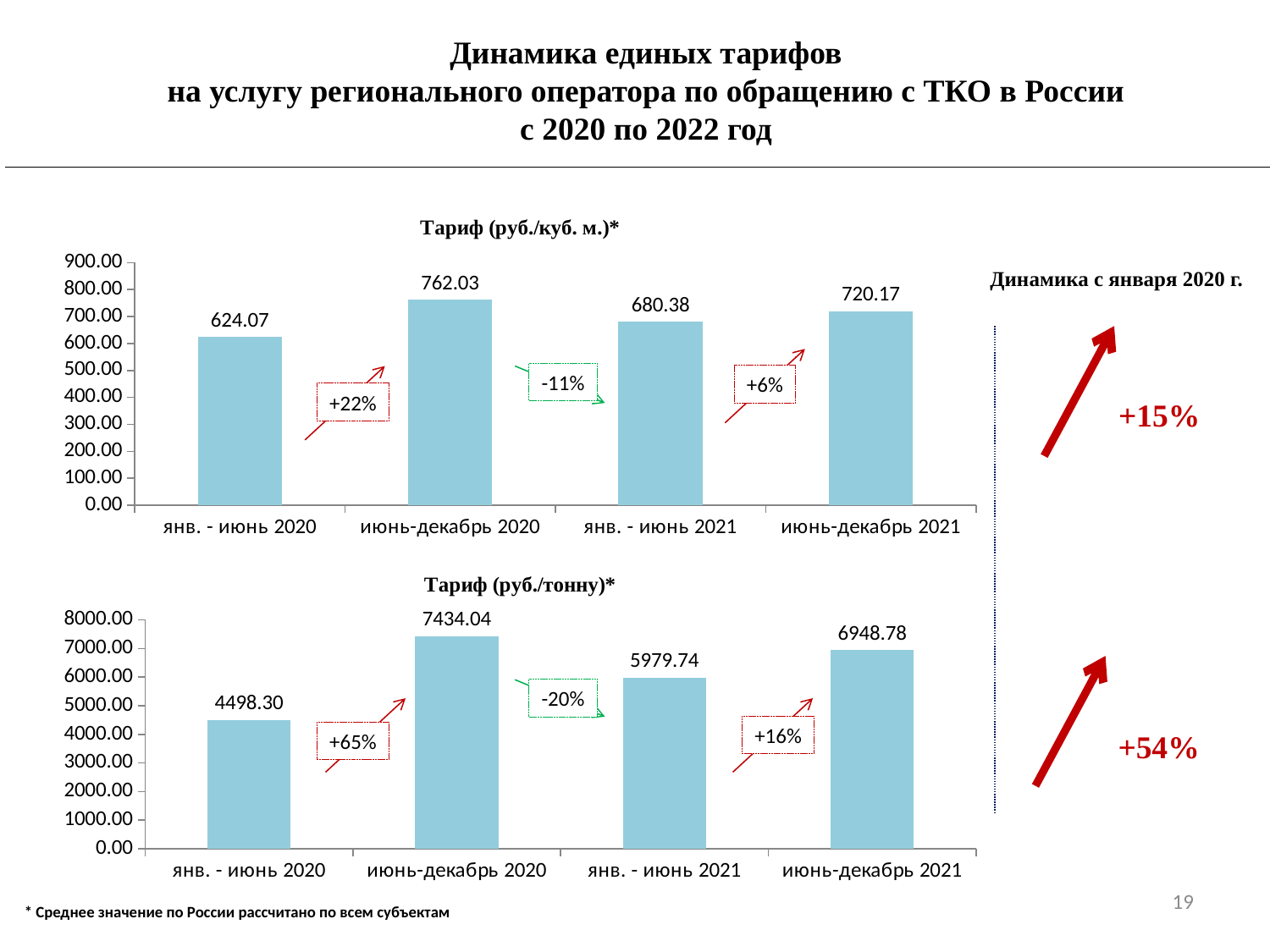
In the chart titled "Тариф (руб./куб. м.)*", which is larger: the value for "янв. - июнь 2021" or the value for "июнь-декабрь 2021"? июнь-декабрь 2021 In the chart titled "Тариф (руб./тонну)*", what is the value for "янв. - июнь 2021"? 5979.74 What is the title of the bottom chart on the slide? Тариф (руб./тонну)* In the chart titled "Тариф (руб./тонну)*", what is the difference between the values for "июнь-декабрь 2020" and "янв. - июнь 2020"? 2935.74 How many categories are shown in the chart titled "Тариф (руб./куб. м.)*"? 4 In the chart titled "Тариф (руб./куб. м.)*", what is the difference between the values for "июнь-декабрь 2020" and "янв. - июнь 2020"? 137.96 In the chart titled "Тариф (руб./тонну)*", which category has the highest value? июнь-декабрь 2020 In the chart titled "Тариф (руб./куб. м.)*", what is the value for "июнь-декабрь 2020"? 762.03 In the chart titled "Тариф (руб./тонну)*", is the value for "июнь-декабрь 2021" greater or less than 6000.00? greater In the chart titled "Тариф (руб./куб. м.)*", which category has the lowest value? янв. - июнь 2020 In the chart titled "Тариф (руб./куб. м.)*", what is the value for "июнь-декабрь 2021"? 720.17 What kind of chart is the chart titled "Тариф (руб./тонну)*"? bar chart